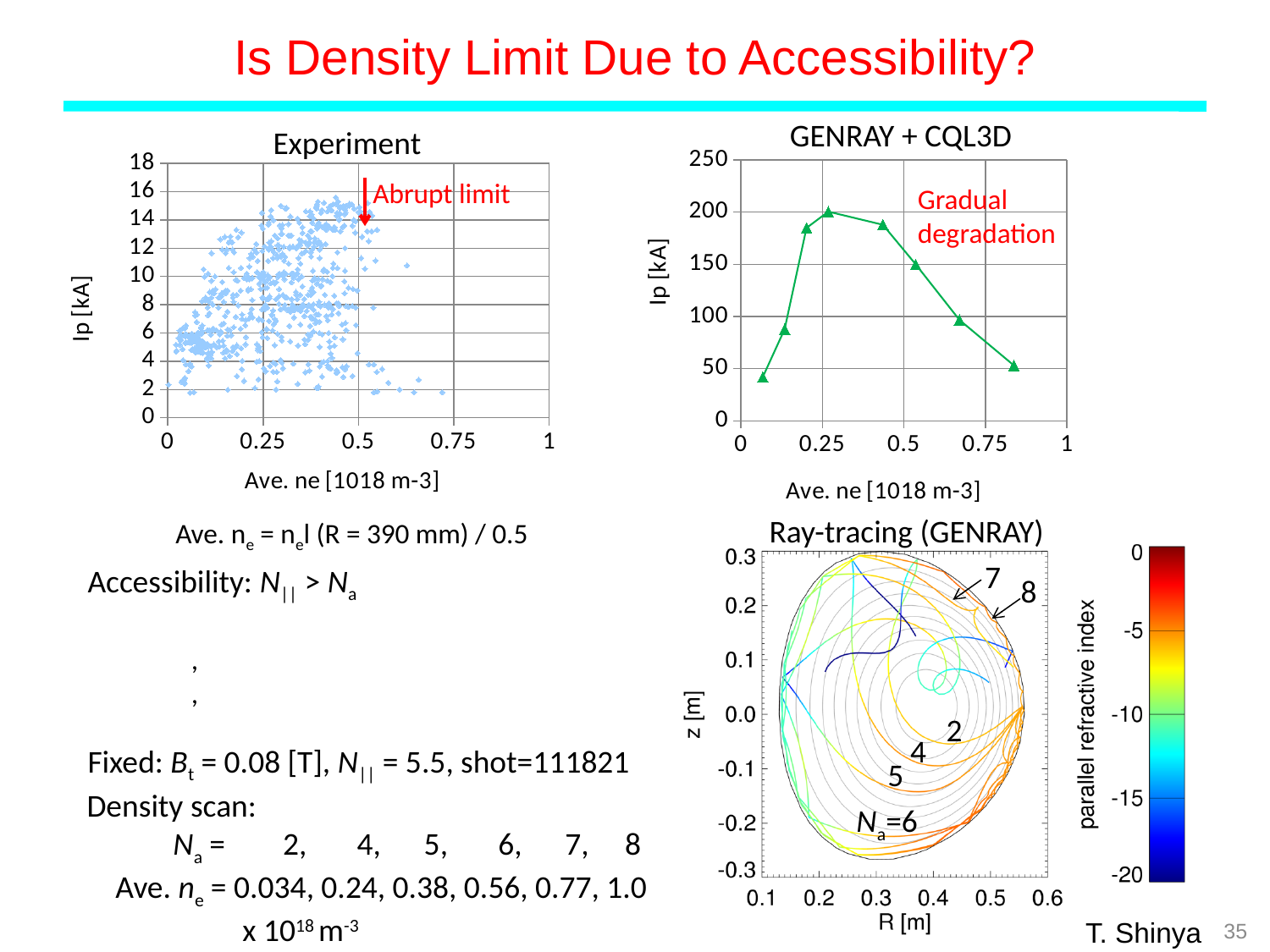
What is the y-axis label of the "Experiment" chart? Ip [kA] In the "GENRAY + CQL3D" chart, which data point has the highest Ip: the one near Ave. ne = 0.27 or the one near Ave. ne = 0.53? the one near Ave. ne = 0.27 In the "GENRAY + CQL3D" chart, does Ip rise or fall as Ave. ne increases from 0.25 to 0.85? fall What is the maximum value shown on the y axis of the "Experiment" chart? 18 What is the label of the colour bar next to the "Ray-tracing (GENRAY)" chart? parallel refractive index What kind of chart is the "Experiment" chart on the left of the slide? scatter chart What kind of chart is the "GENRAY + CQL3D" chart? line chart How many data points are plotted in the "GENRAY + CQL3D" chart? 8 In the "GENRAY + CQL3D" chart, is the Ip value of the second data point (near Ave. ne = 0.14) greater or less than 100? less In the "GENRAY + CQL3D" chart, which data point has the lowest Ip: the first point (near Ave. ne = 0.07) or the last point (near Ave. ne = 0.83)? the first point (near Ave. ne = 0.07) In the "GENRAY + CQL3D" chart, is the Ip value of the third data point (near Ave. ne = 0.2) greater or less than 150? greater In the "GENRAY + CQL3D" chart, is the Ip value of the first data point (at the lowest Ave. ne) greater or less than 50? less